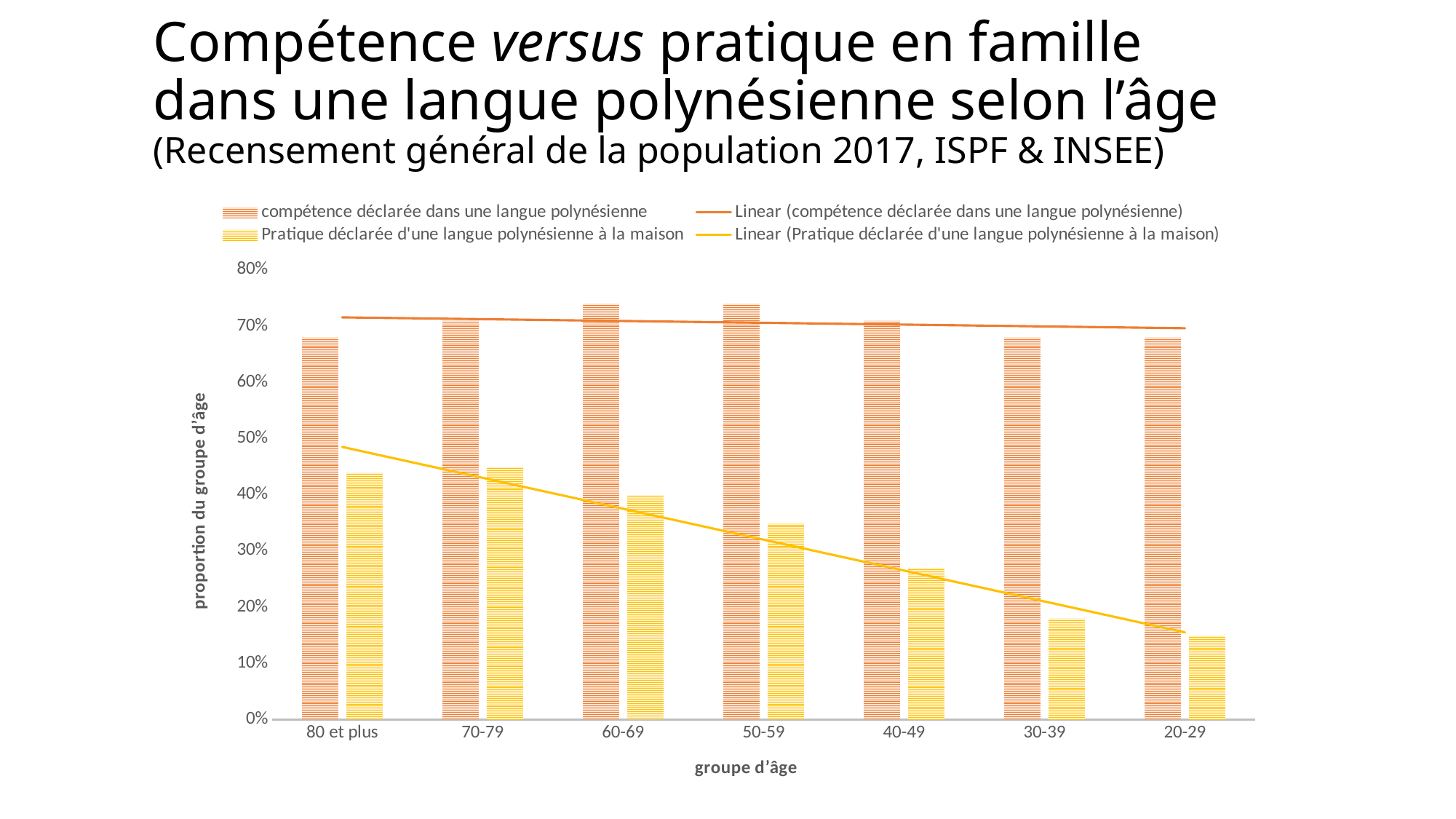
Is the value for 'compétence déclarée dans une langue polynésienne' for 60-69 greater or less than 70%? greater How many entries does the legend list? 4 Does the 'Pratique déclarée d'une langue polynésienne à la maison' series rise or fall from 80 et plus to 20-29 along the x axis? fall Which age group has the lowest value for 'Pratique déclarée d'une langue polynésienne à la maison'? 20-29 Is the value for 'compétence déclarée dans une langue polynésienne' for 80 et plus greater or less than 70%? less What kind of chart is shown on the slide? bar chart Is the value for 'Pratique déclarée d'une langue polynésienne à la maison' for 20-29 greater or less than 20%? less How many age groups are shown on the x axis? 7 For the 20-29 age group, which is larger: 'compétence déclarée dans une langue polynésienne' or 'Pratique déclarée d'une langue polynésienne à la maison'? compétence déclarée dans une langue polynésienne What is the title of the x axis? groupe d'âge